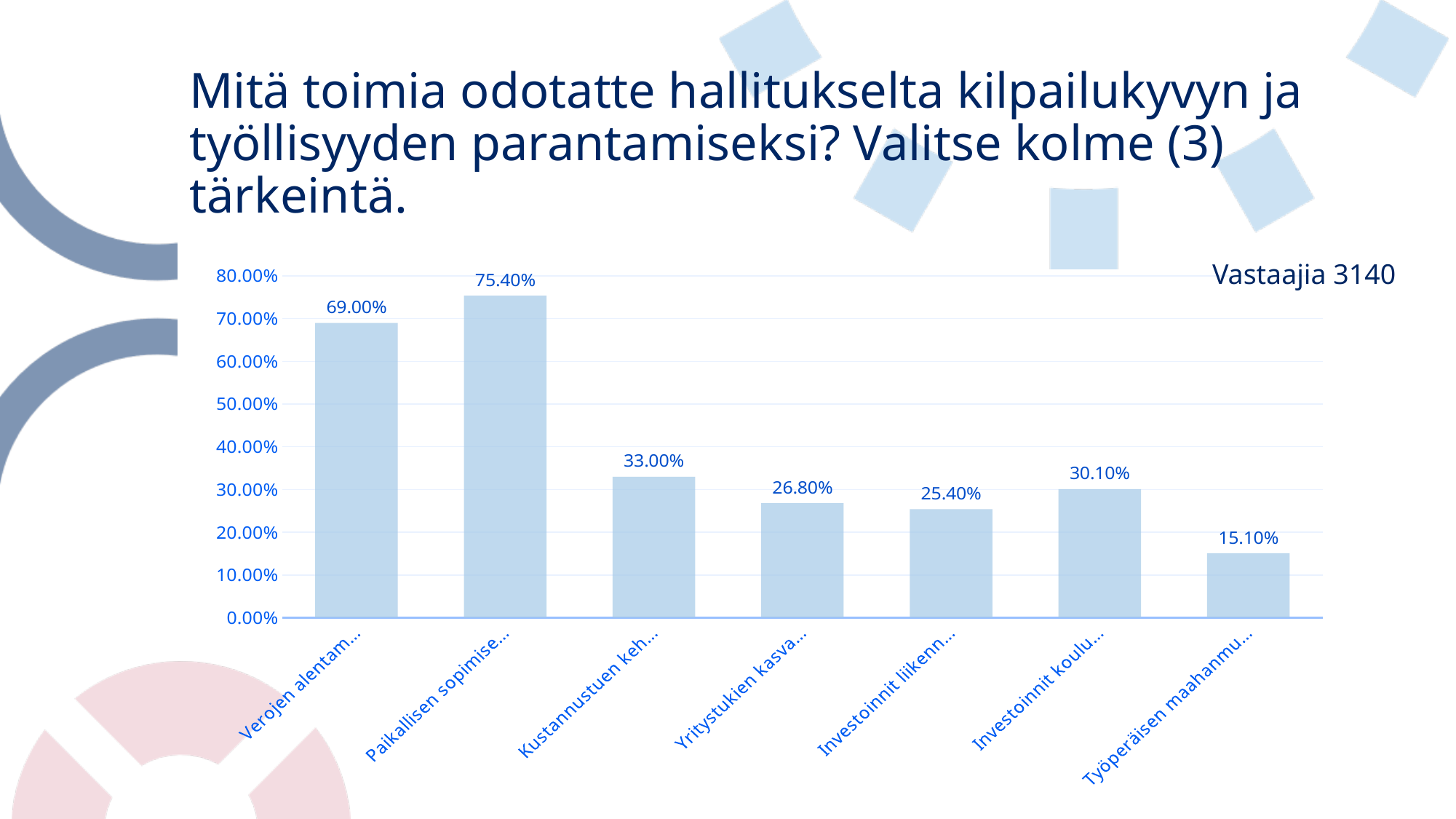
What is the value of the bar labelled "Paikallisen sopimise..."? 75.40% What is the value of the bar labelled "Investoinnit koulu..."? 30.10% Which category has the lowest value? Työperäisen maahanmu... Which category has the highest value? Paikallisen sopimise... What is the value of the last bar, labelled "Työperäisen maahanmu..."? 15.10% How many respondents (Vastaajia) does the slide report? 3140 What is the difference between the values for "Paikallisen sopimise..." and "Verojen alentam..."? 6.40% Is the value for "Yritystukien kasva..." greater or less than 30.00%? less How many bars (categories) does the chart show? 7 What kind of chart is shown on the slide? bar chart Which is larger, the value for "Kustannustuen keh..." or the value for "Investoinnit koulu..."? Kustannustuen keh... What is the value of the first bar, labelled "Verojen alentam..."? 69.00%